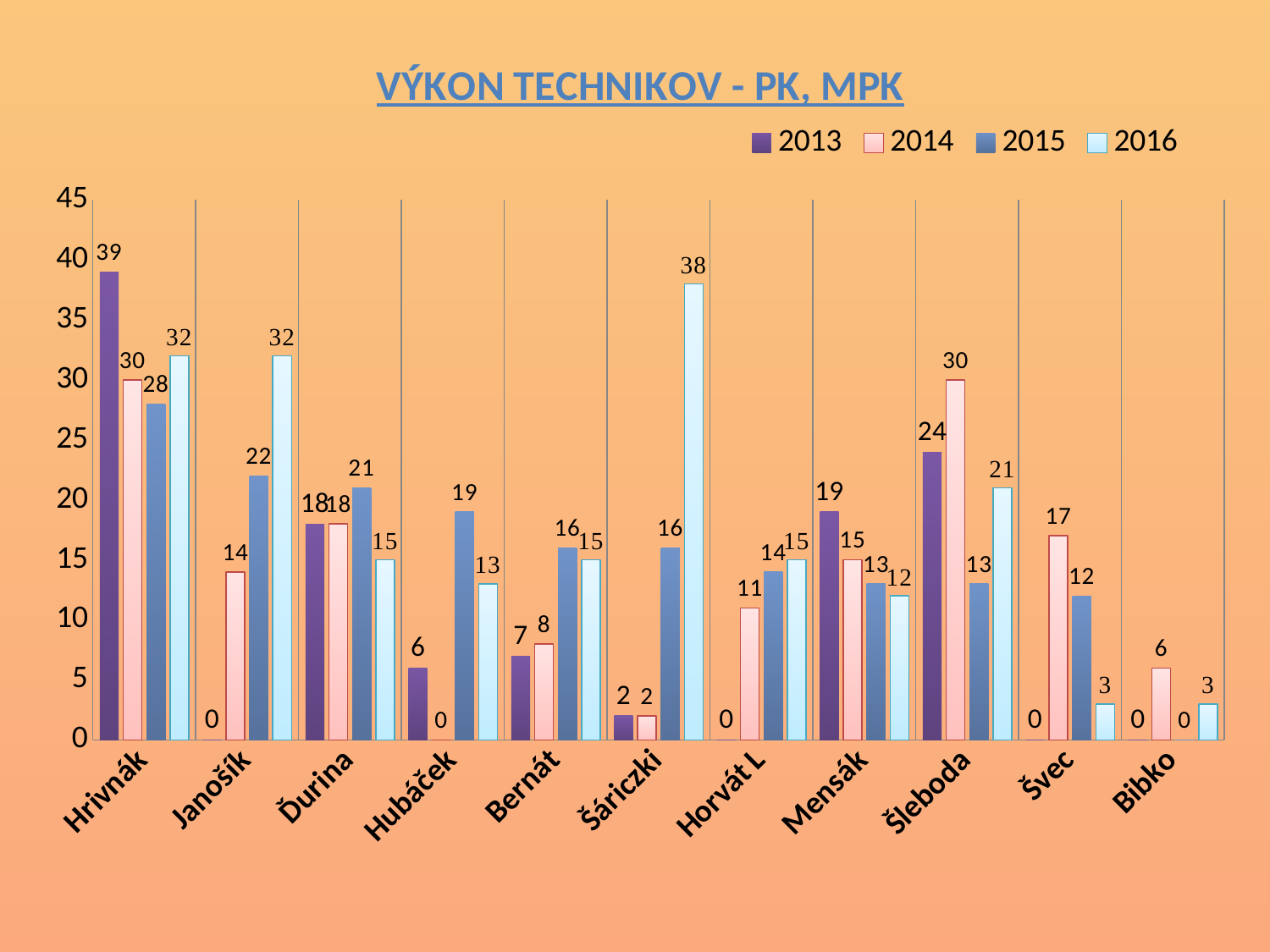
How many technicians are shown on the x axis? 11 What is the value for Šleboda in 2014? 30 What is the difference between Janošík's 2016 value and his 2015 value? 10 What is the value for Hrivnák in 2013? 39 Which technician has the lowest value in 2015? Bibko What is the value for Šáriczki in 2016? 38 Which is larger: Mensák's 2013 value or Šleboda's 2013 value? Šleboda's 2013 value Which technician has the highest value in 2016? Šáriczki What is the title of the chart? VÝKON TECHNIKOV - PK, MPK What kind of chart is shown on the slide? Bar chart How many series does the legend list? 4 Do Mensák's values rise or fall from 2013 to 2016? Fall